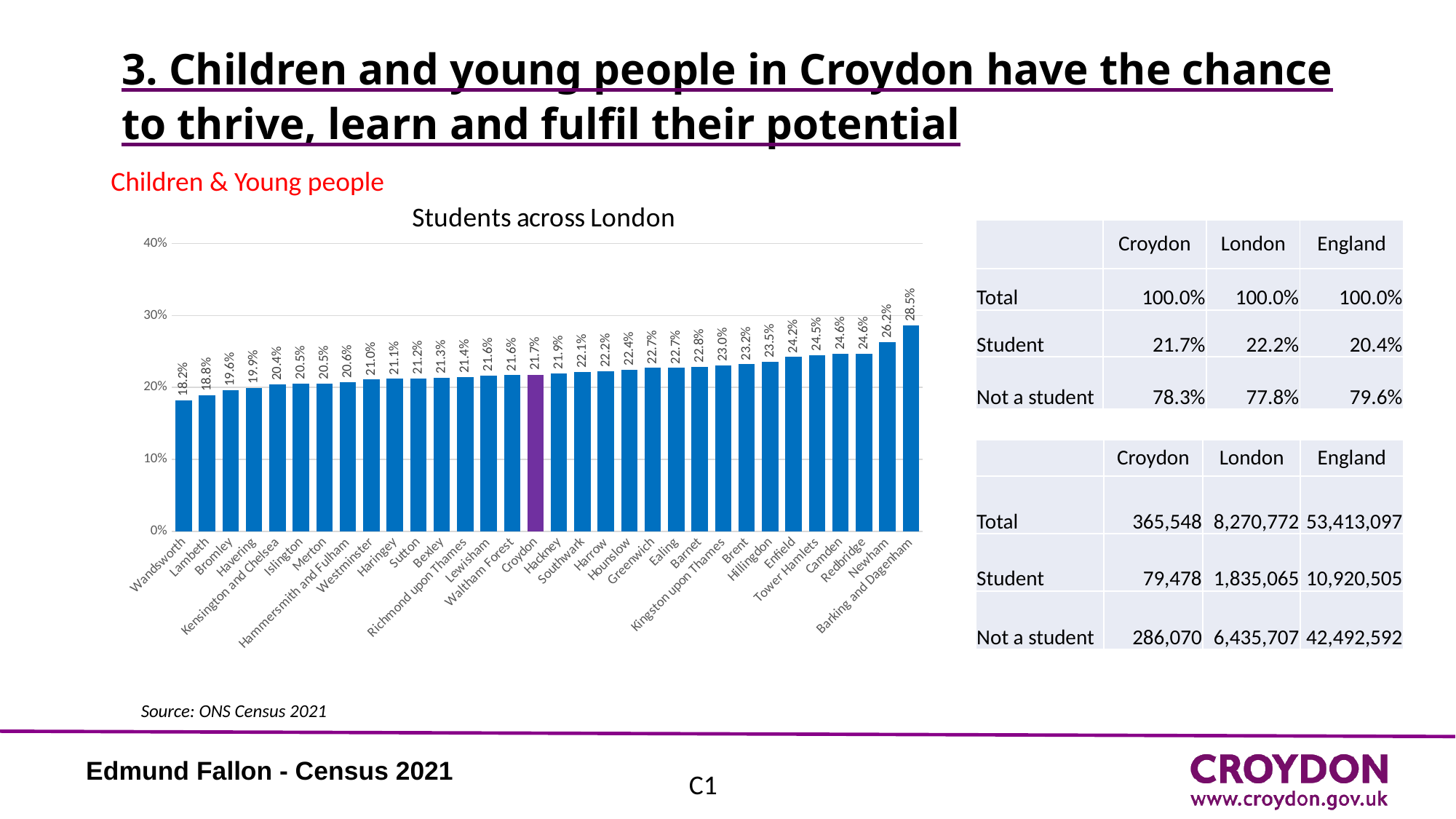
How many boroughs are shown in the 'Students across London' chart? 32 What kind of chart is 'Students across London'? Bar chart In the 'Students across London' chart, what is the value for Newham? 26.2% In the 'Students across London' chart, is the value for Lambeth greater or less than 20%? less In the 'Students across London' chart, what is the difference between the values for Barking and Dagenham and Wandsworth? 10.3 percentage points In the 'Students across London' chart, what is the value for Croydon? 21.7% In the 'Students across London' chart, which borough's bar is coloured purple instead of blue? Croydon In the 'Students across London' chart, what is the value for Barking and Dagenham? 28.5% In the 'Students across London' chart, which borough has the lowest value? Wandsworth In the 'Students across London' chart, which is larger, the value for Newham or the value for Croydon? Newham In the 'Students across London' chart, which borough has the highest value? Barking and Dagenham In the 'Students across London' chart, do the values rise or fall from left to right along the x axis? Rise